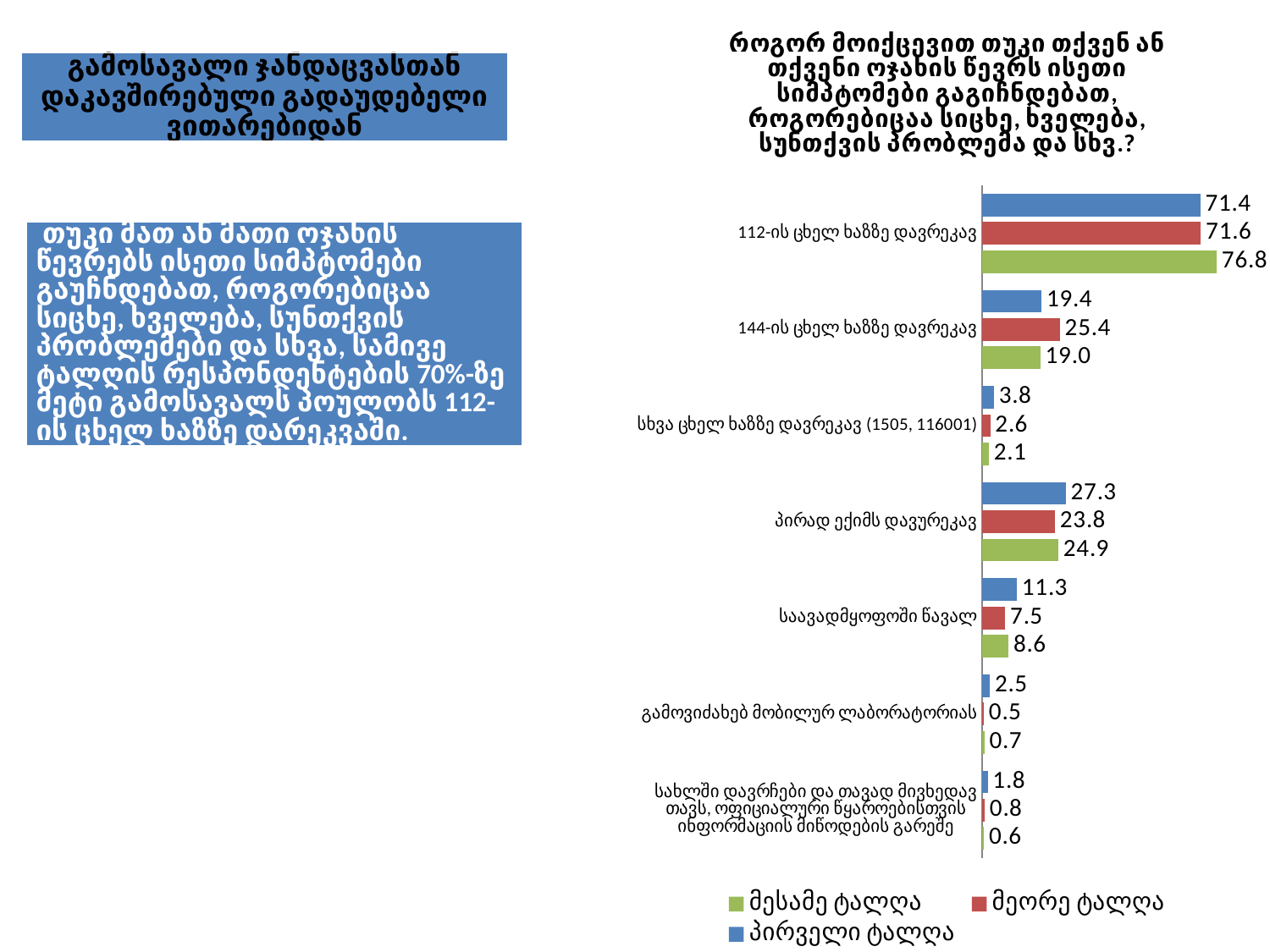
What is the value for "პირად ექიმს დავურეკავ" in the "პირველი ტალღა" series? 27.3 What is the difference between the "მესამე ტალღა" and "პირველი ტალღა" values for "112-ის ცხელ ხაზზე დავრეკავ"? 5.4 Which category has the lowest value in the "მესამე ტალღა" series? სახლში დავრჩები და თავად მივხედავ თავს, ოფიციალური წყაროებისთვის ინფორმაციის მიწოდების გარეშე For "საავადმყოფოში წავალ", which series has the larger value: "პირველი ტალღა" or "მეორე ტალღა"? პირველი ტალღა What is the value for "144-ის ცხელ ხაზზე დავრეკავ" in the "მეორე ტალღა" series? 25.4 How many categories are shown on the chart? 7 Which series is shown in green in the legend? მესამე ტალღა How many series does the legend list? 3 What is the value for "112-ის ცხელ ხაზზე დავრეკავ" in the "მესამე ტალღა" series? 76.8 What is the value for "გამოვიძახებ მობილურ ლაბორატორიას" in the "მეორე ტალღა" series? 0.5 Which category has the highest value in the "პირველი ტალღა" series? 112-ის ცხელ ხაზზე დავრეკავ What type of chart is shown on the slide? bar chart